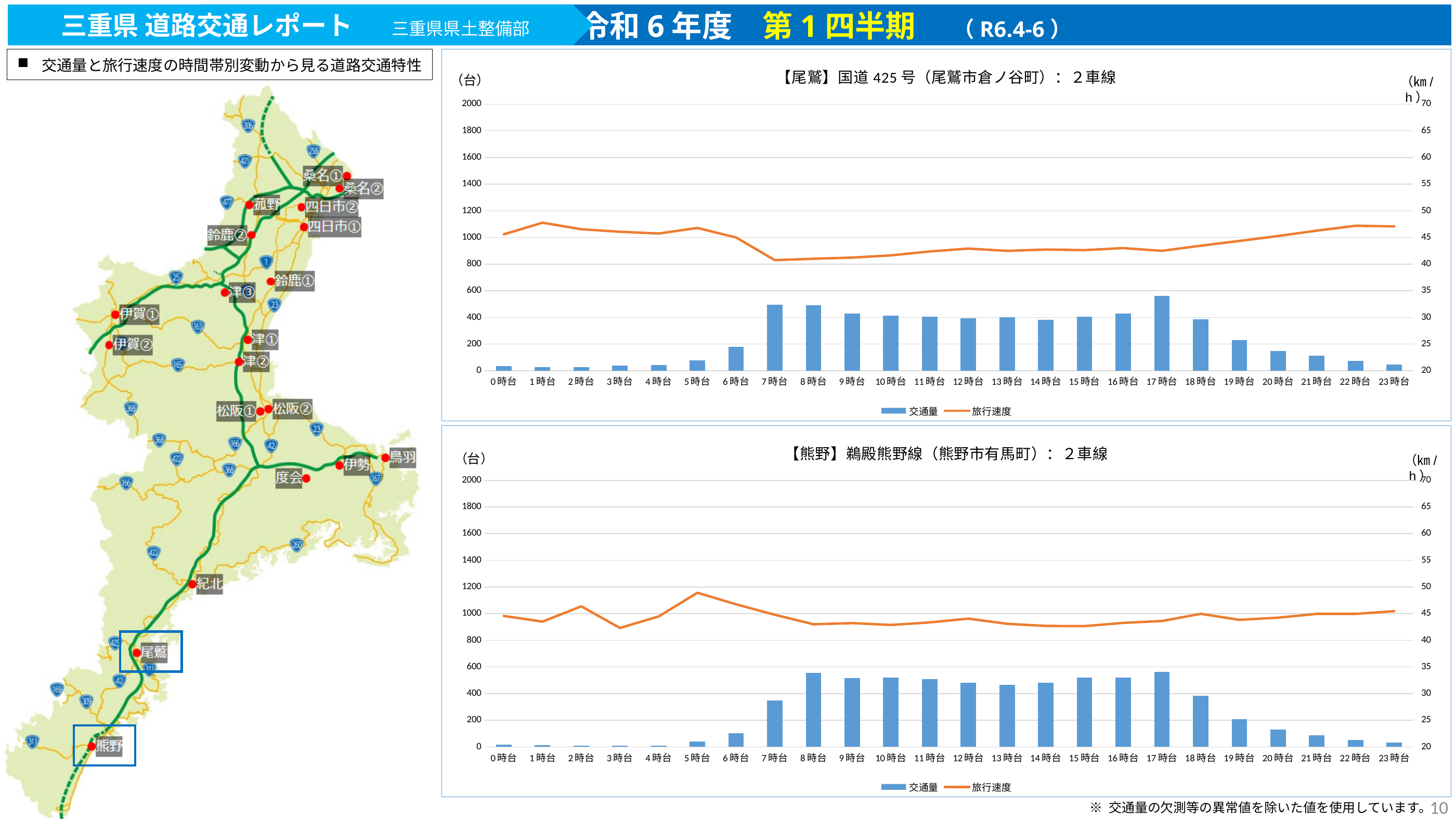
What kind of chart is the bottom chart (【熊野】鵜殿熊野線)? Combined bar and line chart In the top chart (【尾鷲】国道425号), which has the larger traffic volume, 17時台 or 18時台? 17時台 What are the two legend entries in the top chart (【尾鷲】国道425号)? 交通量 and 旅行速度 In the top chart (【尾鷲】国道425号), does the travel speed line rise or fall from 1時台 to 7時台? fall In the bottom chart (【熊野】鵜殿熊野線), which has the larger traffic volume, 7時台 or 8時台? 8時台 In the bottom chart (【熊野】鵜殿熊野線), do the traffic volume bars rise or fall from 17時台 to 23時台? fall In the top chart (【尾鷲】国道425号), which hour has the highest traffic volume bar? 17時台 How many hourly categories are shown on the x axis of the top chart (【尾鷲】国道425号)? 24 In the top chart (【尾鷲】国道425号), is the traffic volume for 17時台 greater or less than 400? greater In the bottom chart (【熊野】鵜殿熊野線), is the traffic volume for 7時台 greater or less than 400? less How many series does the legend of the bottom chart (【熊野】鵜殿熊野線) list? 2 In the top chart (【尾鷲】国道425号), is the traffic volume for 19時台 greater or less than 400? less